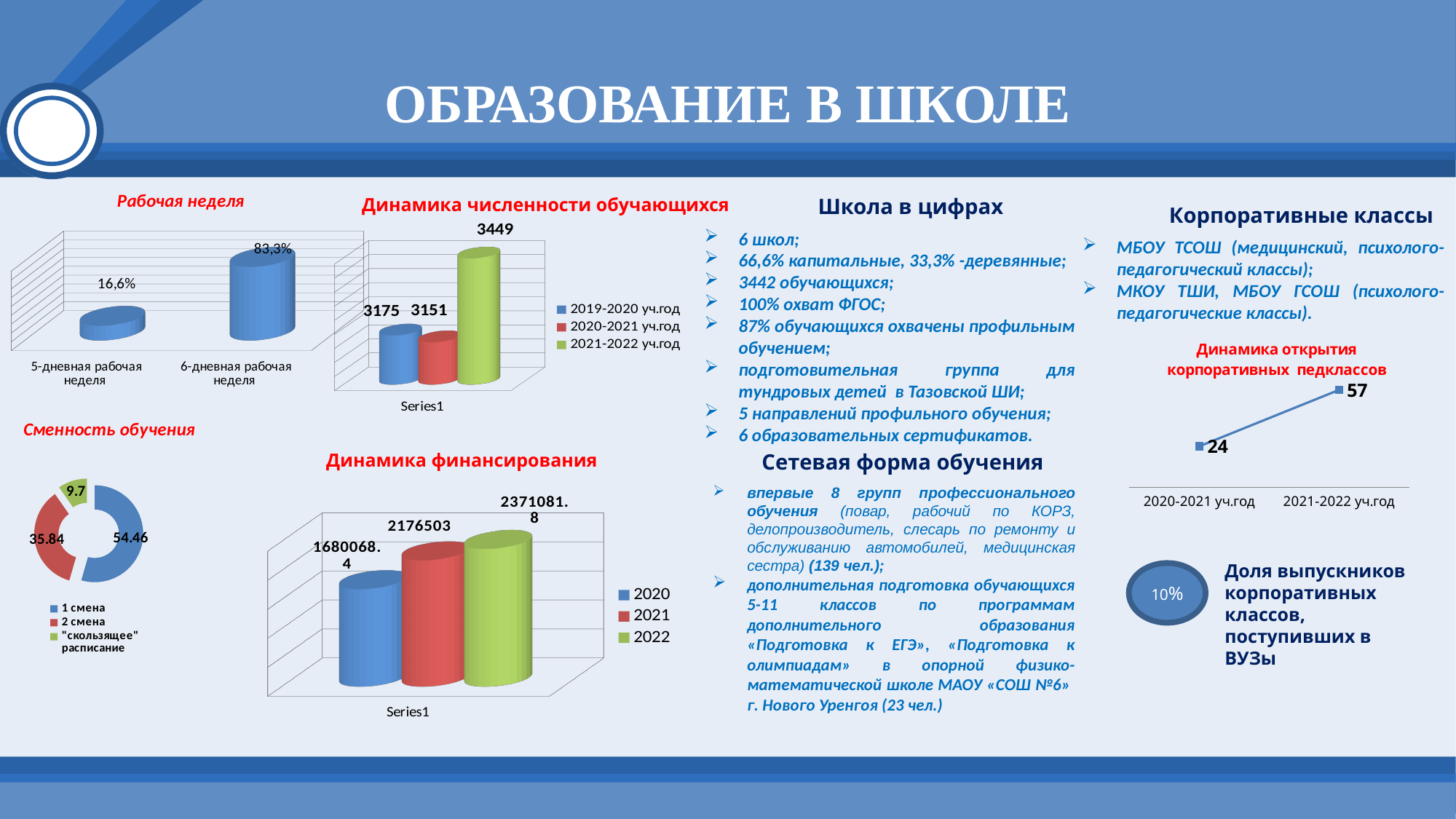
In the 'Сменность обучения' chart, which category has the largest value? 1 смена In the 'Динамика численности обучающихся' chart, which school year has the lowest value? 2020-2021 уч.год In the 'Рабочая неделя' chart, what is the value for '6-дневная рабочая неделя'? 83,3% What kind of chart is 'Сменность обучения'? Doughnut chart In the 'Динамика открытия корпоративных педклассов' chart, what is the value for 2021-2022 уч.год? 57 How many series does the legend of the 'Динамика численности обучающихся' chart list? 3 In the 'Рабочая неделя' chart, what is the value for '5-дневная рабочая неделя'? 16,6% In the 'Динамика финансирования' chart, what is the value for 2021? 2176503 In the 'Сменность обучения' chart, what is the value for '2 смена'? 35.84 In the 'Динамика численности обучающихся' chart, what is the value for 2021-2022 уч.год? 3449 In the 'Динамика финансирования' chart, do the values rise or fall from 2020 to 2022? Rise In the 'Динамика численности обучающихся' chart, what is the difference between the 2021-2022 уч.год value and the 2019-2020 уч.год value? 274